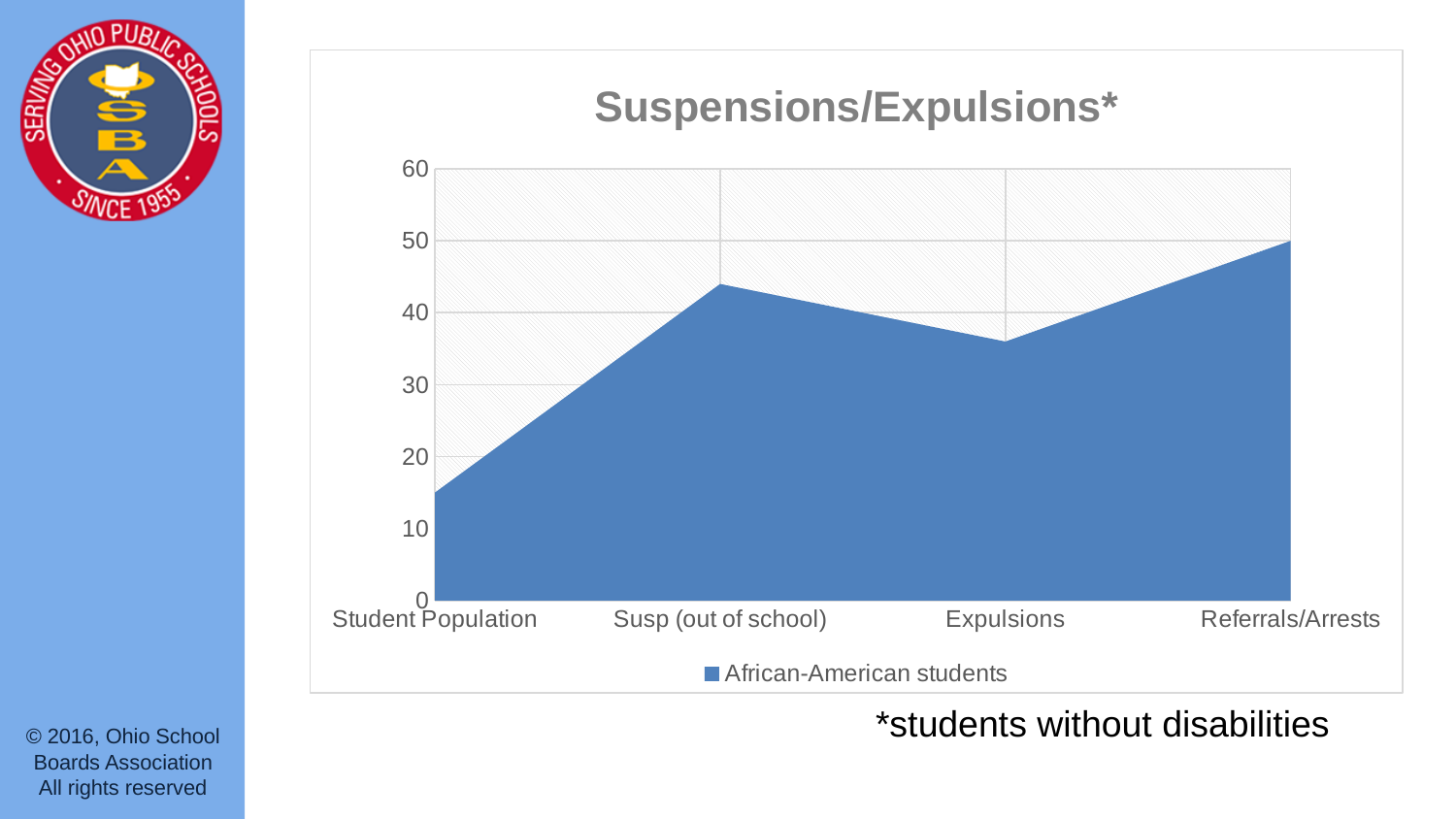
What kind of chart is shown on the slide? Area chart Does the value rise or fall from Student Population to Susp (out of school)? rise Which category has the highest value in the chart? Referrals/Arrests What is the title of the chart? Suspensions/Expulsions* Is the value for Expulsions greater or less than 40? less Which is larger, the value for Susp (out of school) or the value for Expulsions? Susp (out of school) What series name appears in the chart's legend? African-American students Is the value for Susp (out of school) greater or less than 40? greater How many categories are shown along the x axis of the chart? 4 Is the value for Student Population greater or less than 20? less How many series does the chart's legend list? 1 Which category has the lowest value in the chart? Student Population